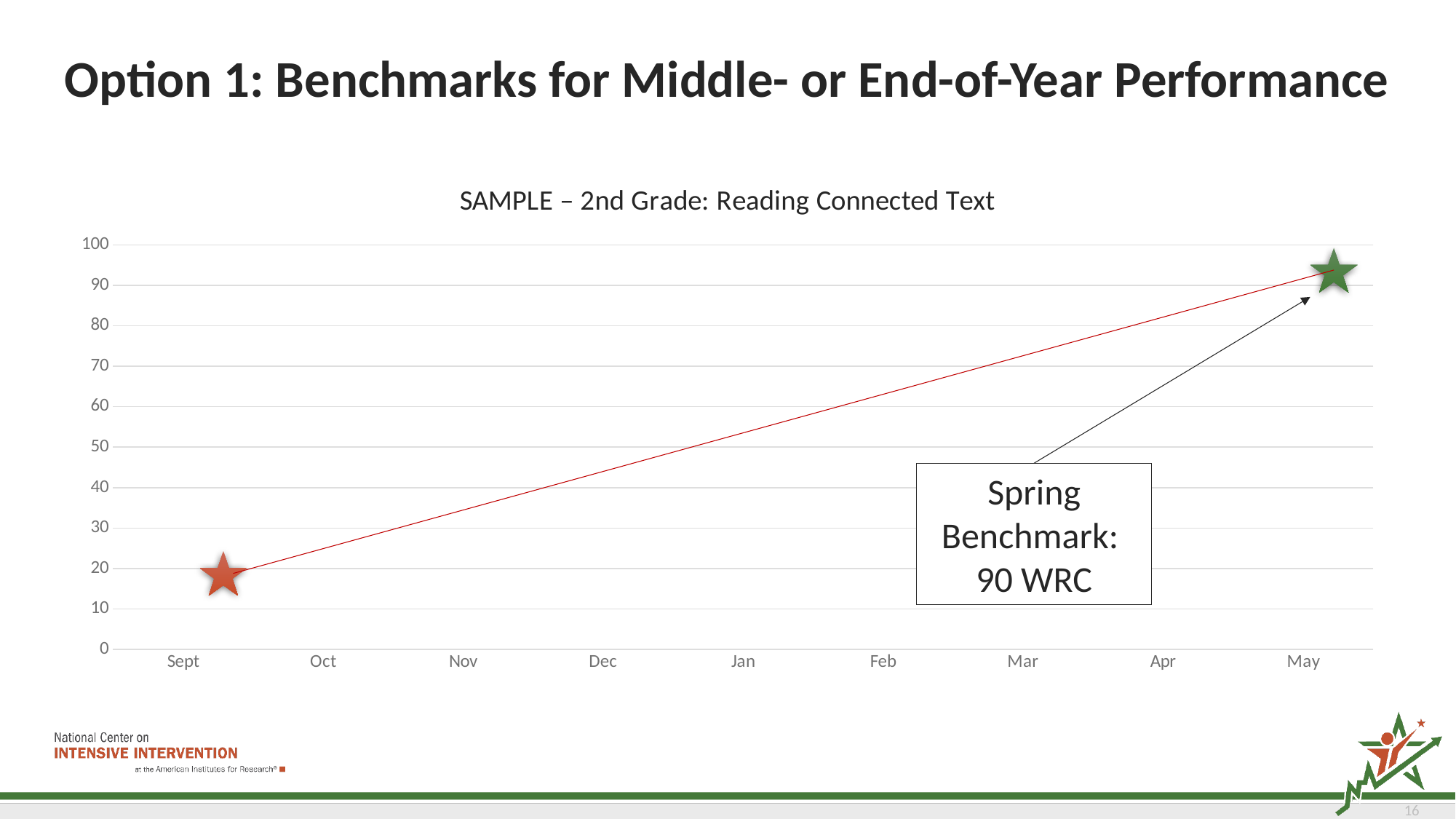
What is the title of the chart? SAMPLE – 2nd Grade: Reading Connected Text Which month has the lowest value on the chart? Sept What is the Spring Benchmark value shown in the callout on the chart? 90 WRC What kind of chart is shown on the slide? line chart Is the value at Sept greater or less than 10? greater Which is larger, the value at Sept or the value at May? May Is the value at Sept greater or less than 30? less How many months are labeled along the x axis of the chart? 9 Which month has the highest value on the chart? May Is the value at May greater or less than 80? greater Does the line on the chart rise or fall from Sept to May? rise What is the highest value shown on the y axis of the chart? 100